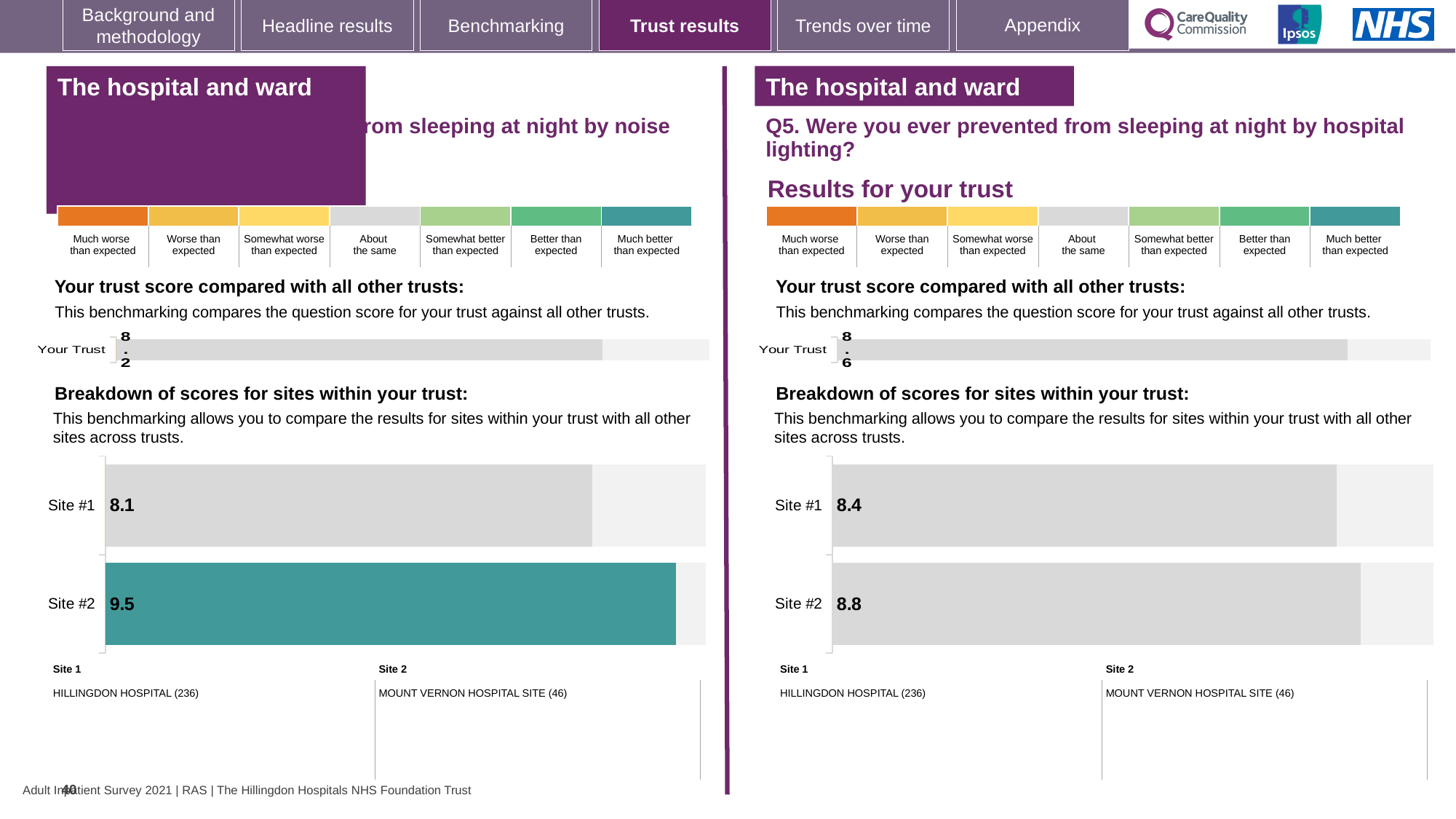
What type of chart is used for the site breakdown on each side of the slide? Bar chart On the right-hand site breakdown chart (Q5, hospital lighting), what is the difference between the Site #2 and Site #1 scores? 0.4 How many sites are shown in each site breakdown chart? 2 On the left-hand chart (sleeping at night by noise), what is the 'Your Trust' score? 8.2 On the right-hand chart (Q5, hospital lighting), what is the score for Site #1? 8.4 On the left-hand site breakdown chart, which site has the higher score? Site #2 On the left-hand chart (sleeping at night by noise), what is the score for Site #1? 8.1 On the left-hand chart (sleeping at night by noise), what is the score for Site #2? 9.5 On the right-hand chart (Q5, hospital lighting), what is the score for Site #2? 8.8 On the right-hand site breakdown chart (Q5, hospital lighting), which site has the lower score? Site #1 On the left-hand site breakdown chart, what is the difference between the Site #2 and Site #1 scores? 1.4 On the right-hand chart (Q5, hospital lighting), what is the 'Your Trust' score? 8.6